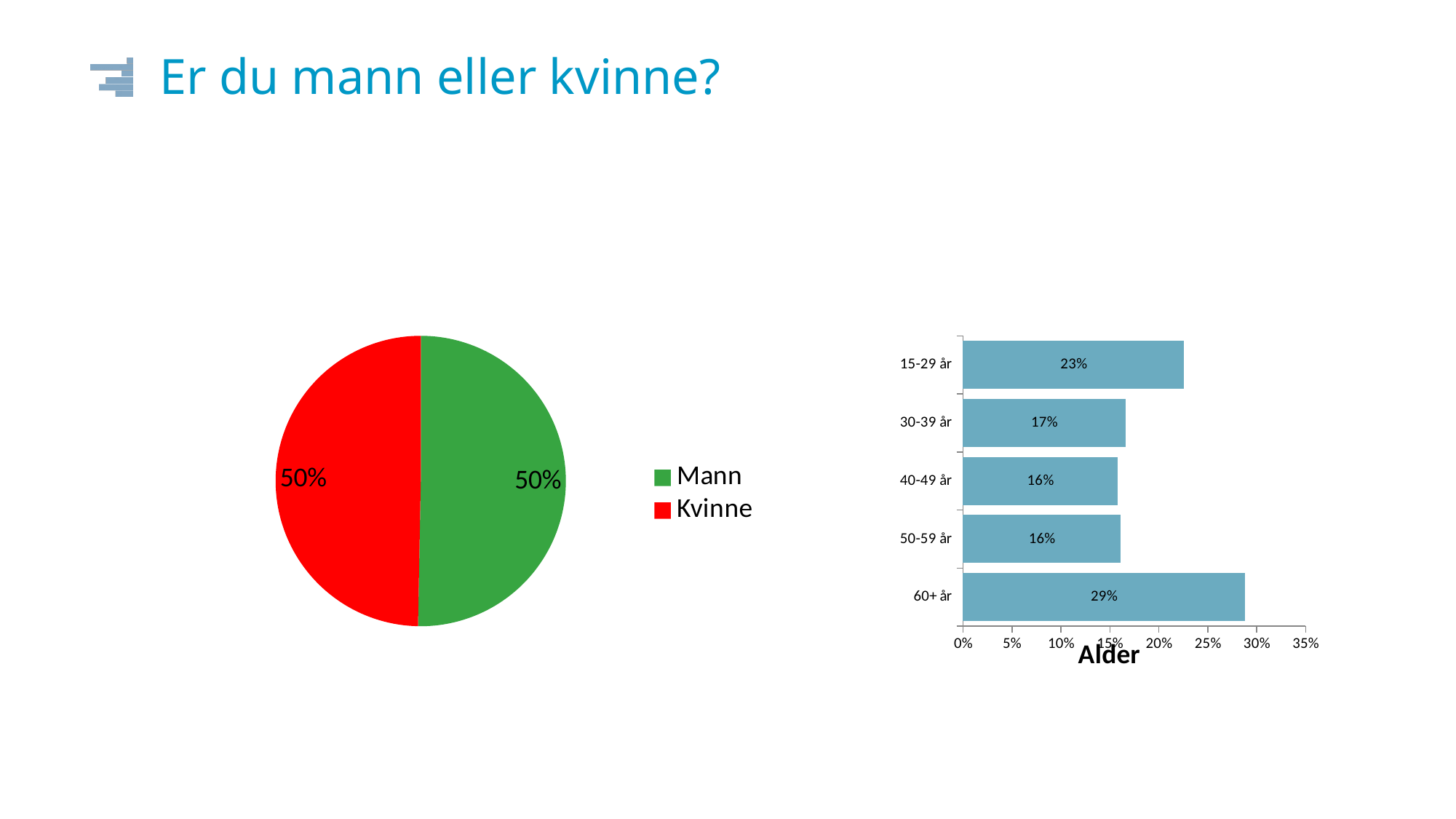
In the pie chart on the left, how many entries does the legend list? 2 In the 'Alder' chart on the right, what is the value for 15-29 år? 23% In the pie chart on the left, what share is labelled for Kvinne? 50% In the 'Alder' chart on the right, what is the difference between the values for 60+ år and 15-29 år? 6% In the 'Alder' chart on the right, how many age groups are shown? 5 What kind of chart is the 'Alder' chart on the right? Bar chart In the 'Alder' chart on the right, what is the value for 30-39 år? 17% In the pie chart on the left, what share is labelled for Mann? 50% In the 'Alder' chart on the right, which is larger, the value for 15-29 år or the value for 30-39 år? 15-29 år What kind of chart is the chart on the left of the slide? Pie chart In the pie chart on the left, what colour is the Kvinne slice? Red In the 'Alder' chart on the right, which age group has the highest value? 60+ år